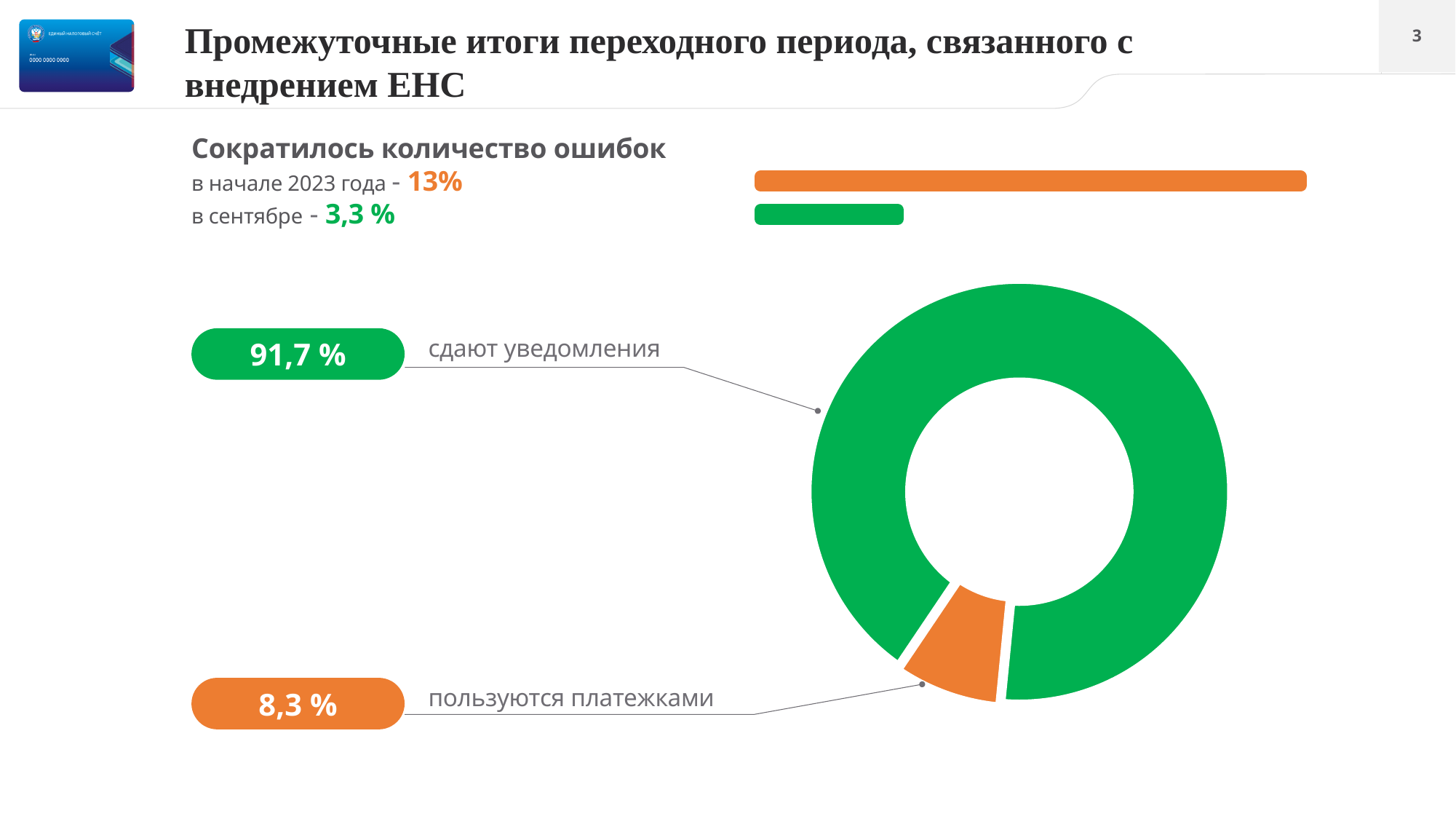
On the bar chart under "Сократилось количество ошибок", what is the value for "в сентябре"? 3,3 % On the bar chart under "Сократилось количество ошибок", how many bars are shown? 2 On the donut chart, which category has the largest slice? сдают уведомления On the donut chart, how many slices are shown? 2 On the bar chart under "Сократилось количество ошибок", which period has the larger value: "в начале 2023 года" or "в сентябре"? в начале 2023 года On the donut chart, which category has the smallest slice? пользуются платежками On the donut chart, what share of the ring corresponds to "сдают уведомления"? 91,7 % On the bar chart under "Сократилось количество ошибок", what is the value for "в начале 2023 года"? 13% On the donut chart, what colour is the slice for "пользуются платежками"? orange On the donut chart, what share corresponds to "пользуются платежками"? 8,3 % What type of chart is the large chart on the right side of the slide? donut (pie) chart On the donut chart, what is the difference between the share for "сдают уведомления" and the share for "пользуются платежками"? 83,4 %